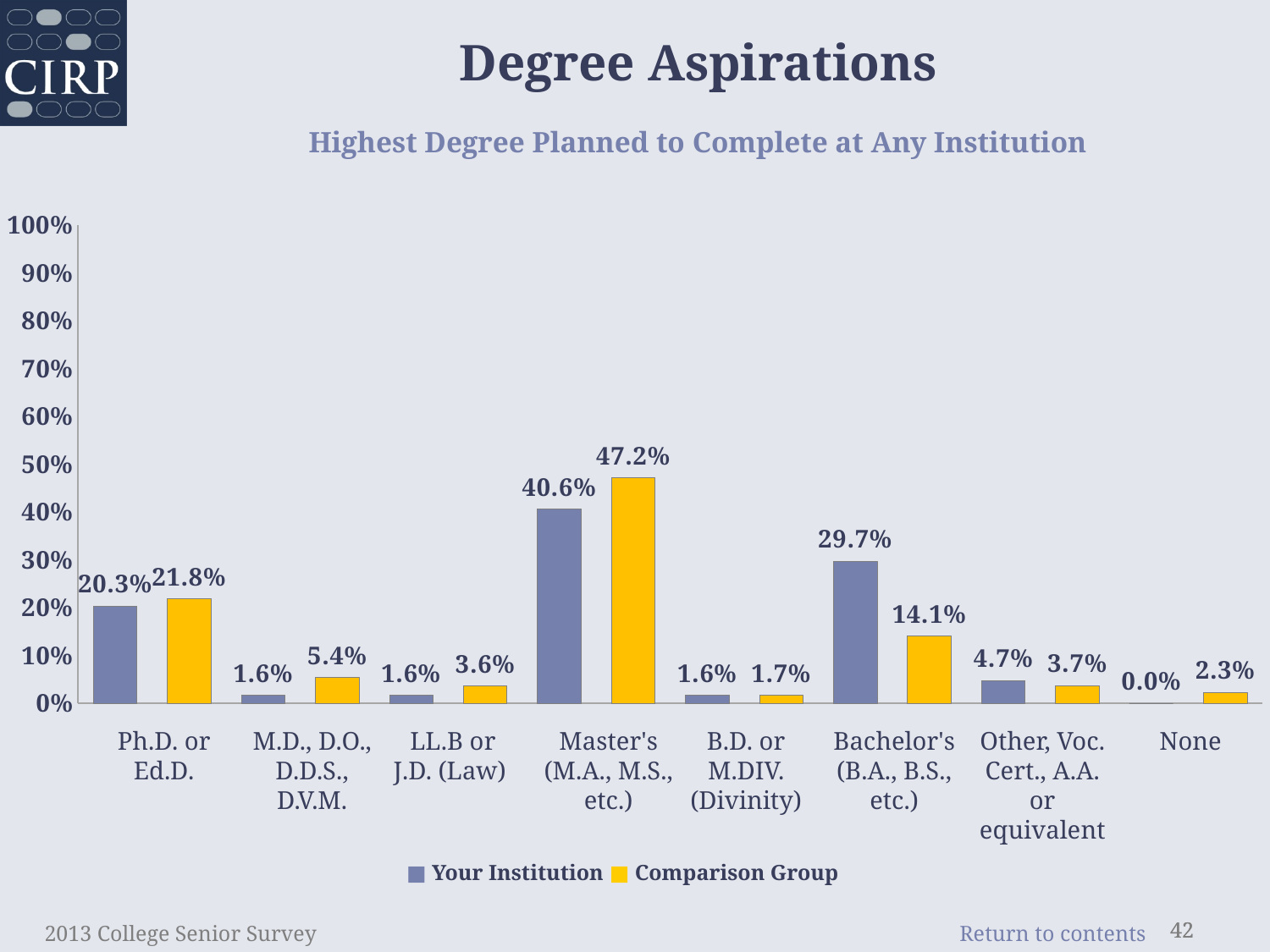
For Ph.D. or Ed.D., which series has the larger value, Your Institution or Comparison Group? Comparison Group What is the subtitle of the chart? Highest Degree Planned to Complete at Any Institution Which category has the lowest Your Institution value? None What is the difference between the Comparison Group and Your Institution values for Bachelor's (B.A., B.S., etc.)? 15.6% How many series does the legend list? 2 Which category has the highest Comparison Group value? Master's (M.A., M.S., etc.) Is the Comparison Group value for Master's (M.A., M.S., etc.) greater or less than 40%? greater What kind of chart is shown on the slide? bar chart How many degree categories are shown on the x axis? 8 What is the Comparison Group value for Bachelor's (B.A., B.S., etc.)? 14.1% What is the Your Institution value for None? 0.0% What is the Your Institution value for Master's (M.A., M.S., etc.)? 40.6%